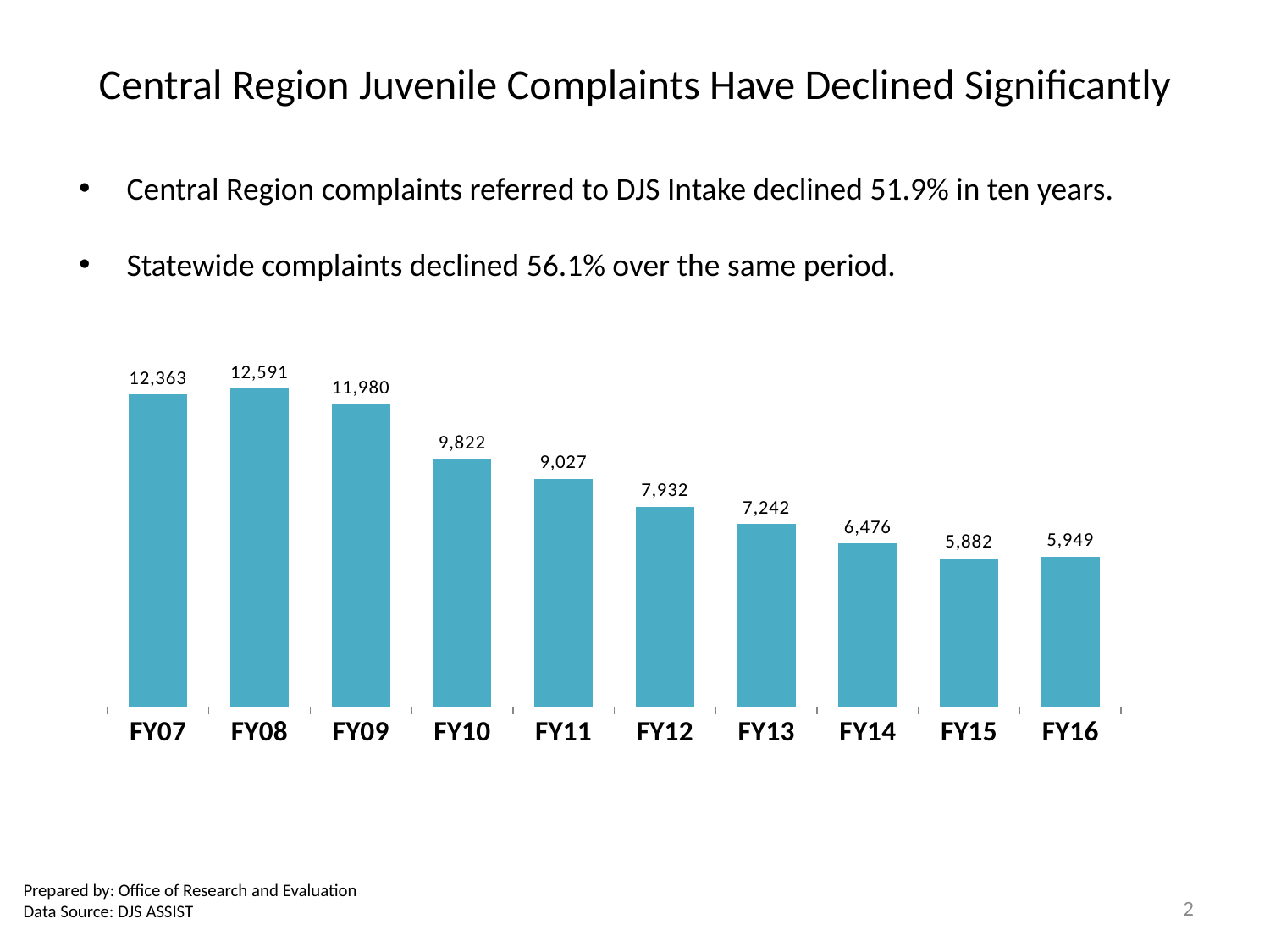
How many fiscal years are shown on the chart? 10 Which is larger, the value for FY09 or the value for FY13? FY09 What kind of chart is shown on the slide? Bar chart What colour are the bars in the chart? Teal blue What is the value for FY12? 7,932 What is the difference between the values for FY10 and FY11? 795 What is the value for FY16? 5,949 Do the values generally rise or fall from FY07 to FY16? Fall Which fiscal year has the highest value? FY08 Which fiscal year has the lowest value? FY15 What is the difference between the values for FY07 and FY16? 6,414 What is the value for FY07? 12,363